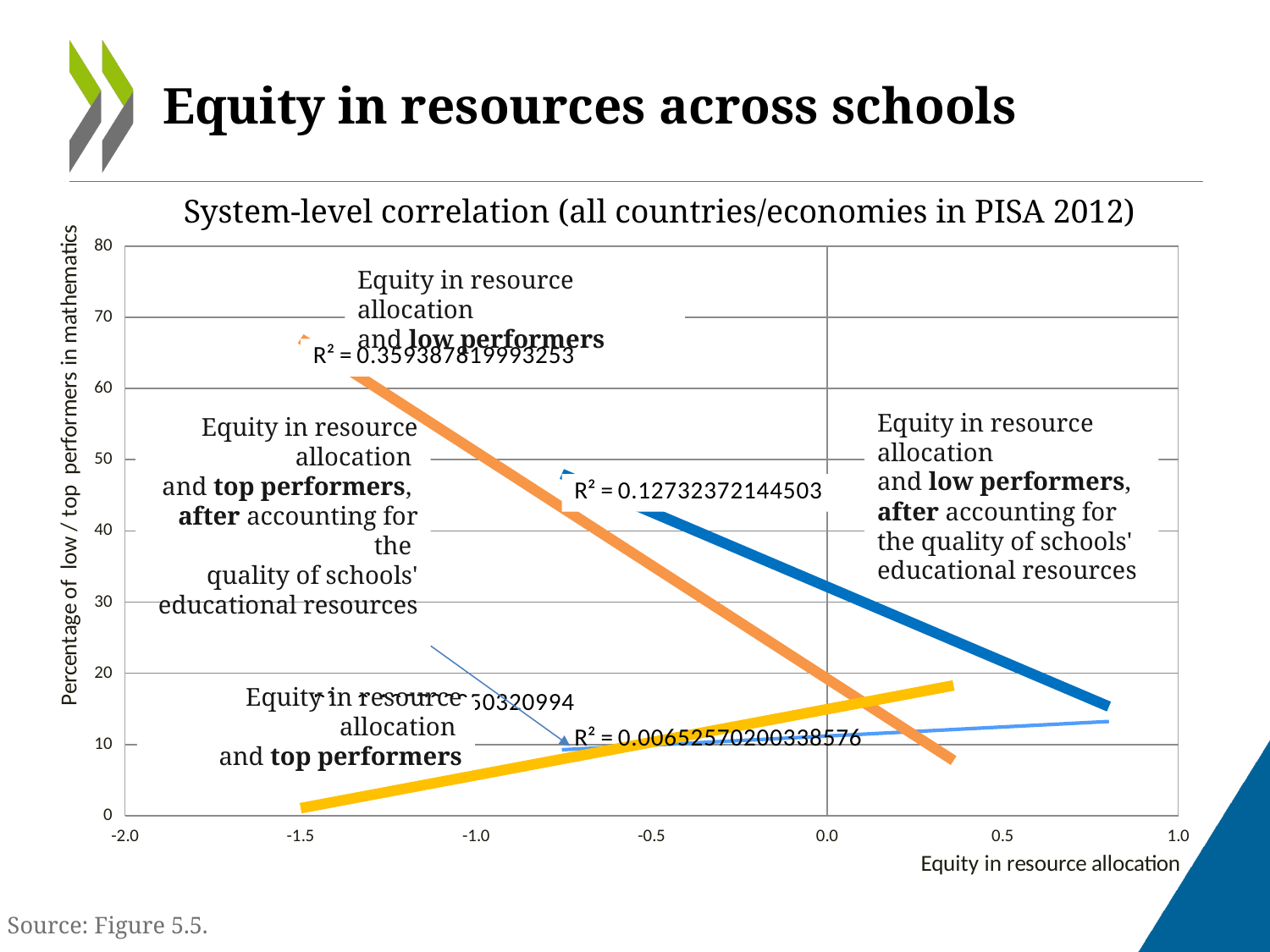
What is the R² value printed for the trend line labelled 'Equity in resource allocation and top performers, after accounting for the quality of schools' educational resources'? R² = 0.00652570200338576 Does the dark blue trend line for low performers after accounting for the quality of schools' educational resources rise or fall along the x axis? Fall How many trend lines are plotted on the chart? 4 What is the label of the vertical axis? Percentage of low / top performers in mathematics Does the orange trend line for 'Equity in resource allocation and low performers' rise or fall as equity in resource allocation increases? Fall Does the yellow trend line for 'Equity in resource allocation and top performers' rise or fall as equity in resource allocation increases? Rise Which trend line has the higher R² value: the one for low performers or the one for low performers after accounting for the quality of schools' educational resources? Low performers What is the title of the chart? System-level correlation (all countries/economies in PISA 2012) What is the R² value printed for the trend line labelled 'Equity in resource allocation and low performers'? R² = 0.359387819993253 What is the R² value printed for the trend line labelled 'Equity in resource allocation and low performers, after accounting for the quality of schools' educational resources'? R² = 0.12732372144503 What kind of chart is shown on the slide? Scatter chart with trend lines What is the maximum value shown on the vertical axis? 80